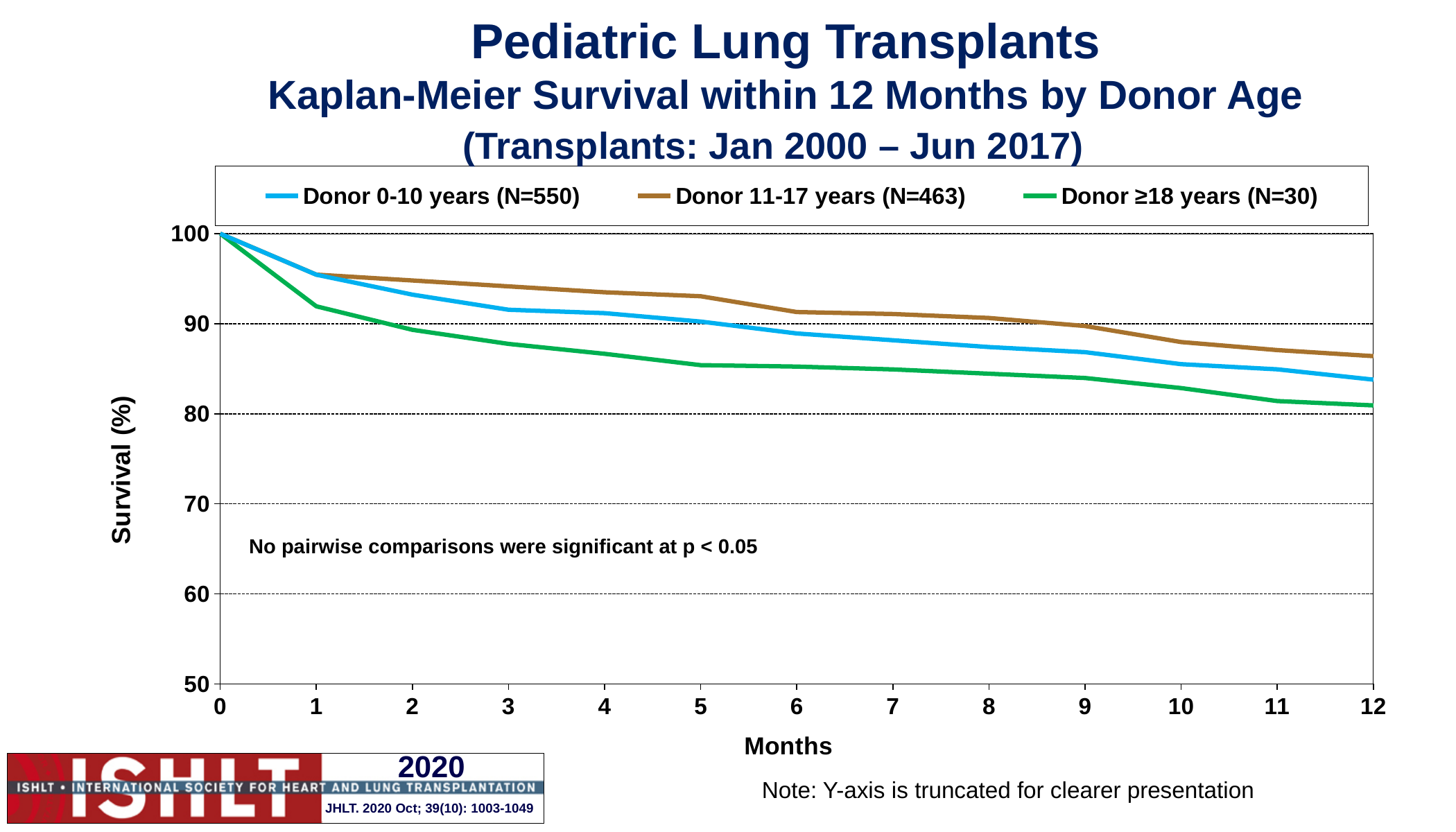
Is the survival value for Donor 0-10 years at 3 months greater or less than 90? greater Do the survival curves rise or fall as months increase? Fall How many series does the legend list? 3 Is the survival value for Donor ≥18 years at 3 months greater or less than 90? less At 6 months, which has higher survival: Donor 11-17 years or Donor ≥18 years? Donor 11-17 years What kind of chart is shown on the slide? Line chart What is the survival value for all three donor age groups at month 0? 100 Is the survival value for Donor 11-17 years at 12 months greater or less than 90? less Which donor age group has the lowest survival at 12 months? Donor ≥18 years (N=30) Which donor age group has the highest survival at 12 months? Donor 11-17 years (N=463) How many transplants (N) are in the Donor 0-10 years group according to the legend? 550